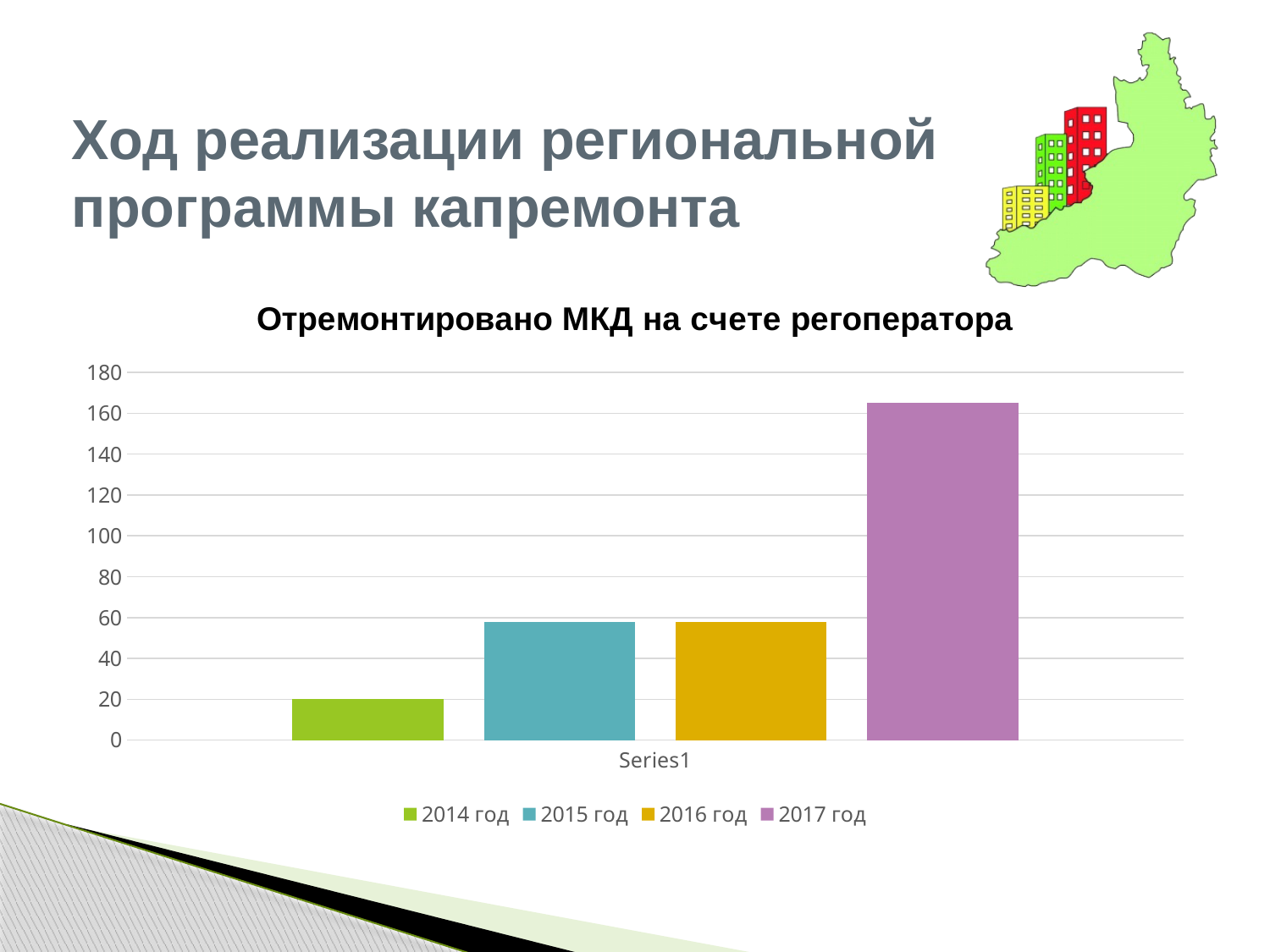
Which year has the lowest bar? 2014 год How many series does the legend list? 4 Which year has the highest bar? 2017 год What is the value for 2014 год? 20 What kind of chart is shown on the slide? bar chart What colour is the bar for 2017 год? purple What is the title of the chart? Отремонтировано МКД на счете регоператора Which is larger, the value for 2017 год or the value for 2015 год? 2017 год Is the value for 2017 год greater or less than 160? greater Is the value for 2016 год greater or less than 40? greater How many bars are plotted in the chart? 4